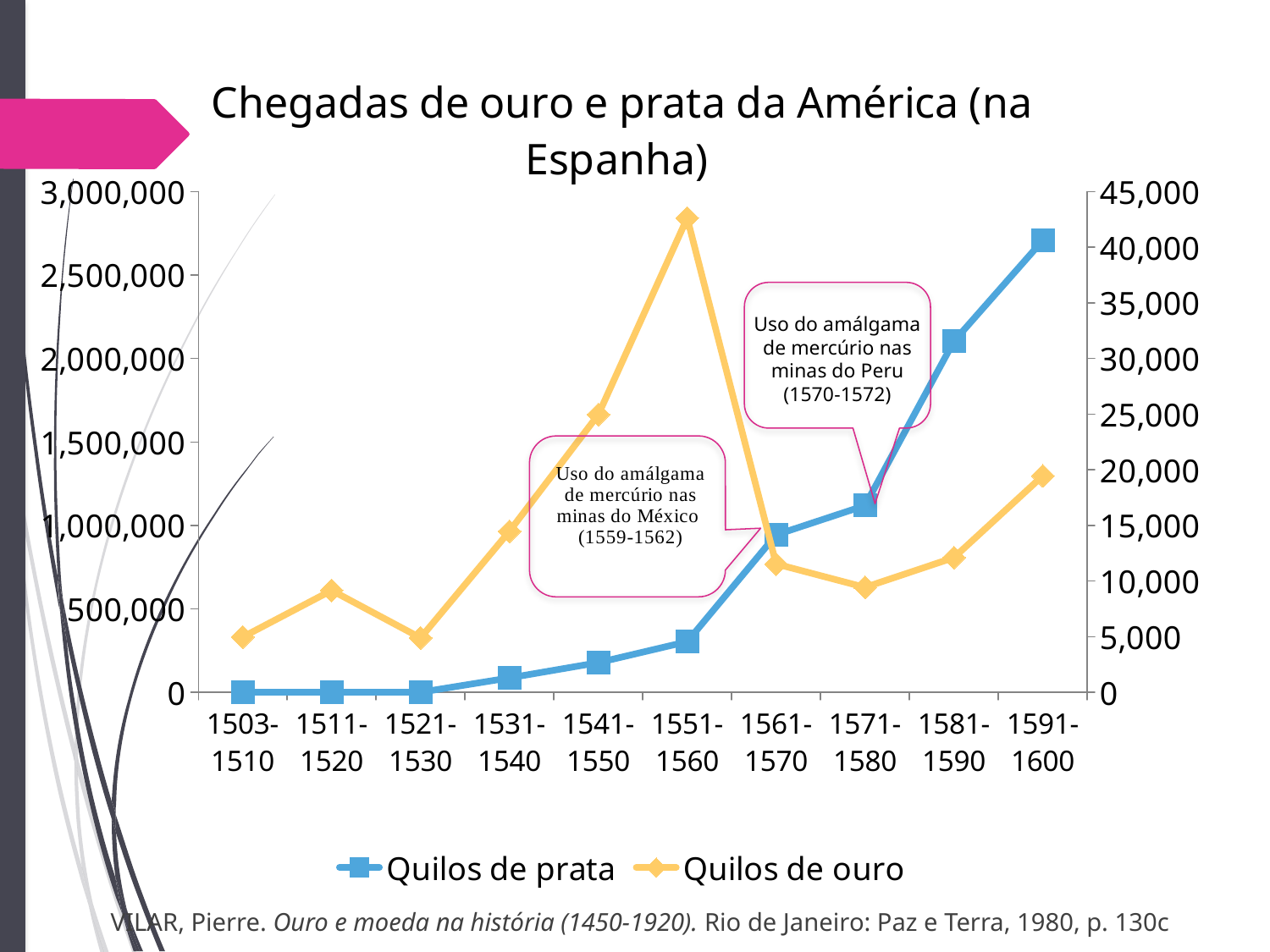
Is the value for Quilos de ouro in 1551-1560 greater or less than 40,000? greater What is the title of the chart? Chegadas de ouro e prata da América (na Espanha) What kind of chart is shown on the slide? line chart In which period is the value for Quilos de prata highest? 1591-1600 Is the value for Quilos de prata in 1551-1560 greater or less than 500,000? less How many periods are shown along the x axis? 10 How many series does the legend list? 2 Is the value for Quilos de ouro in 1571-1580 greater or less than 15,000? less Does the value for Quilos de prata generally rise or fall from 1503-1510 to 1591-1600? rise In which period is the value for Quilos de ouro highest? 1551-1560 Which period has the larger value for Quilos de ouro, 1541-1550 or 1591-1600? 1541-1550